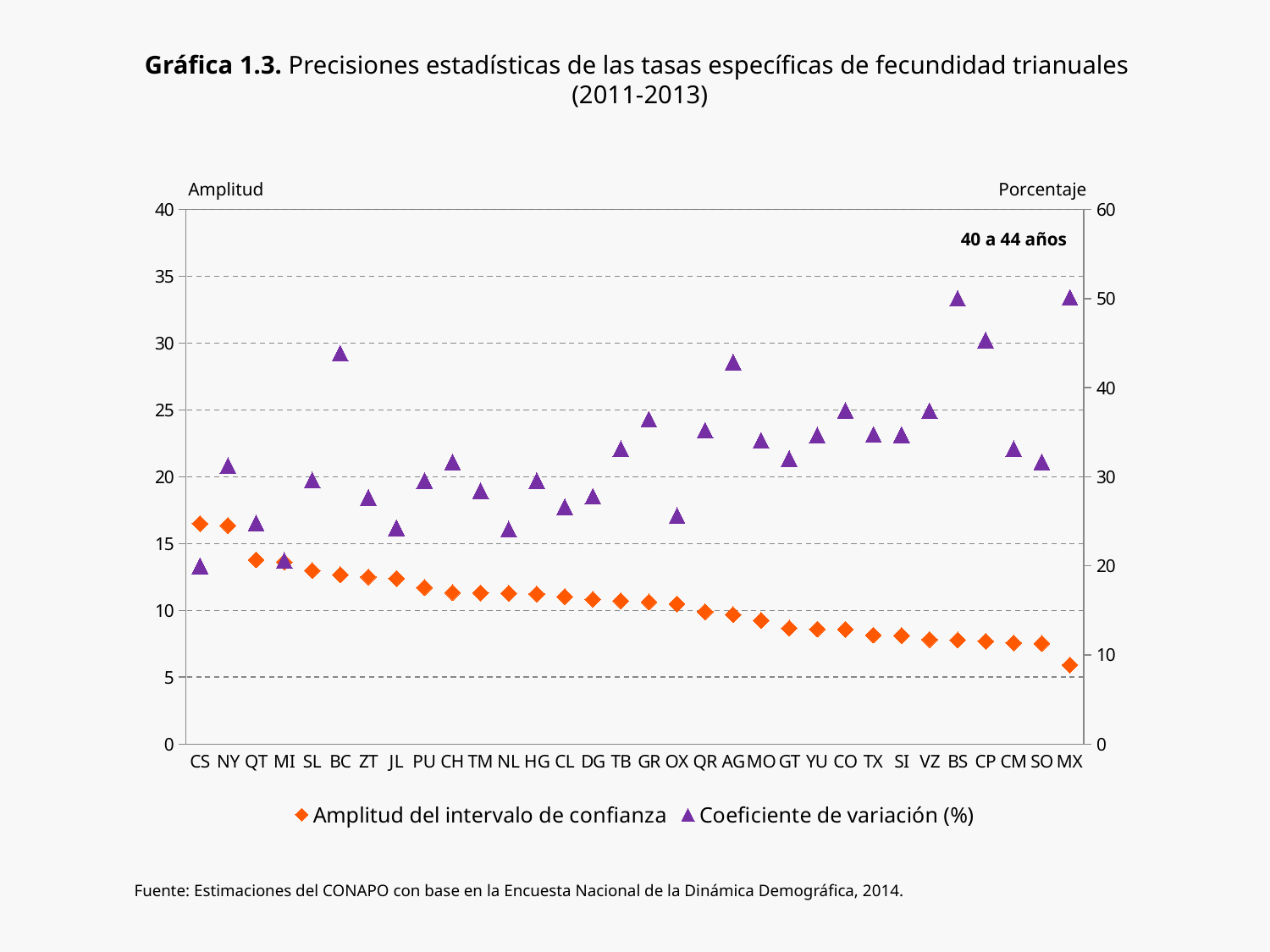
Do the values for Amplitud del intervalo de confianza rise or fall along the x axis from CS to MX? Fall Is the Amplitud del intervalo de confianza value for CS greater or less than 15? greater What kind of chart is shown on the slide? Scatter chart How many series does the legend list? 2 Is the Coeficiente de variación (%) value for NL greater or less than 30? less Which has the larger Coeficiente de variación (%) value, AG or OX? AG Which category has the lowest value for Amplitud del intervalo de confianza? MX Which has the larger Amplitud del intervalo de confianza value, CS or MX? CS Is the Coeficiente de variación (%) value for BC greater or less than 40? greater What age group is indicated in the annotation at the top right of the plot area? 40 a 44 años How many categories are shown along the x axis? 32